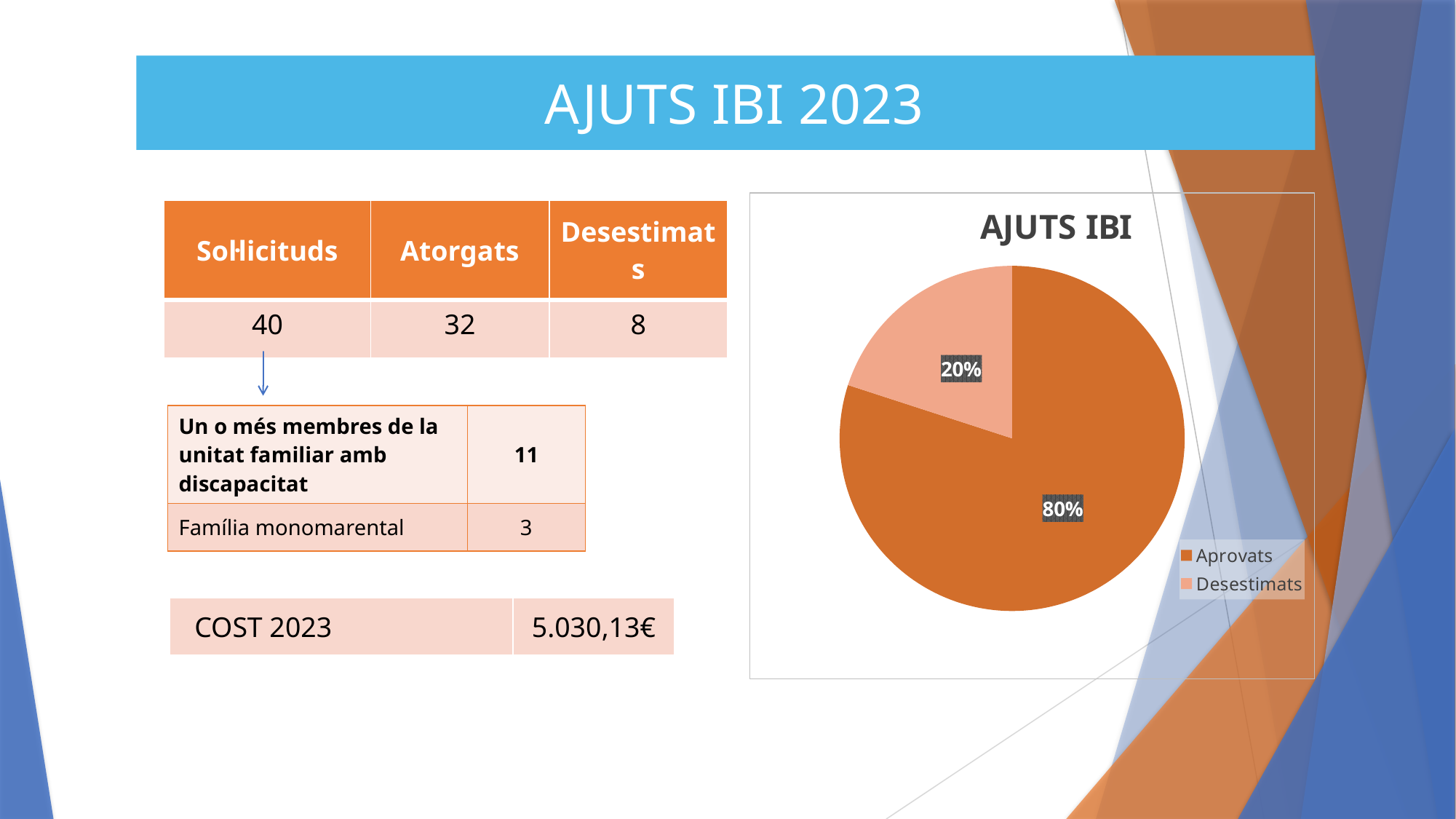
Which legend entry is shown in the lighter orange colour? Desestimats What share of the pie does Aprovats represent? 80% What is the difference in percentage points between the Aprovats and Desestimats slices? 60% What is the title of the chart? AJUTS IBI Which is larger, the Aprovats slice or the Desestimats slice? Aprovats How many slices does the pie chart have? 2 How many entries does the legend list? 2 Which slice of the pie is the largest? Aprovats What kind of chart is shown on the slide? pie chart Which slice of the pie is the smallest? Desestimats What share of the pie does Desestimats represent? 20%